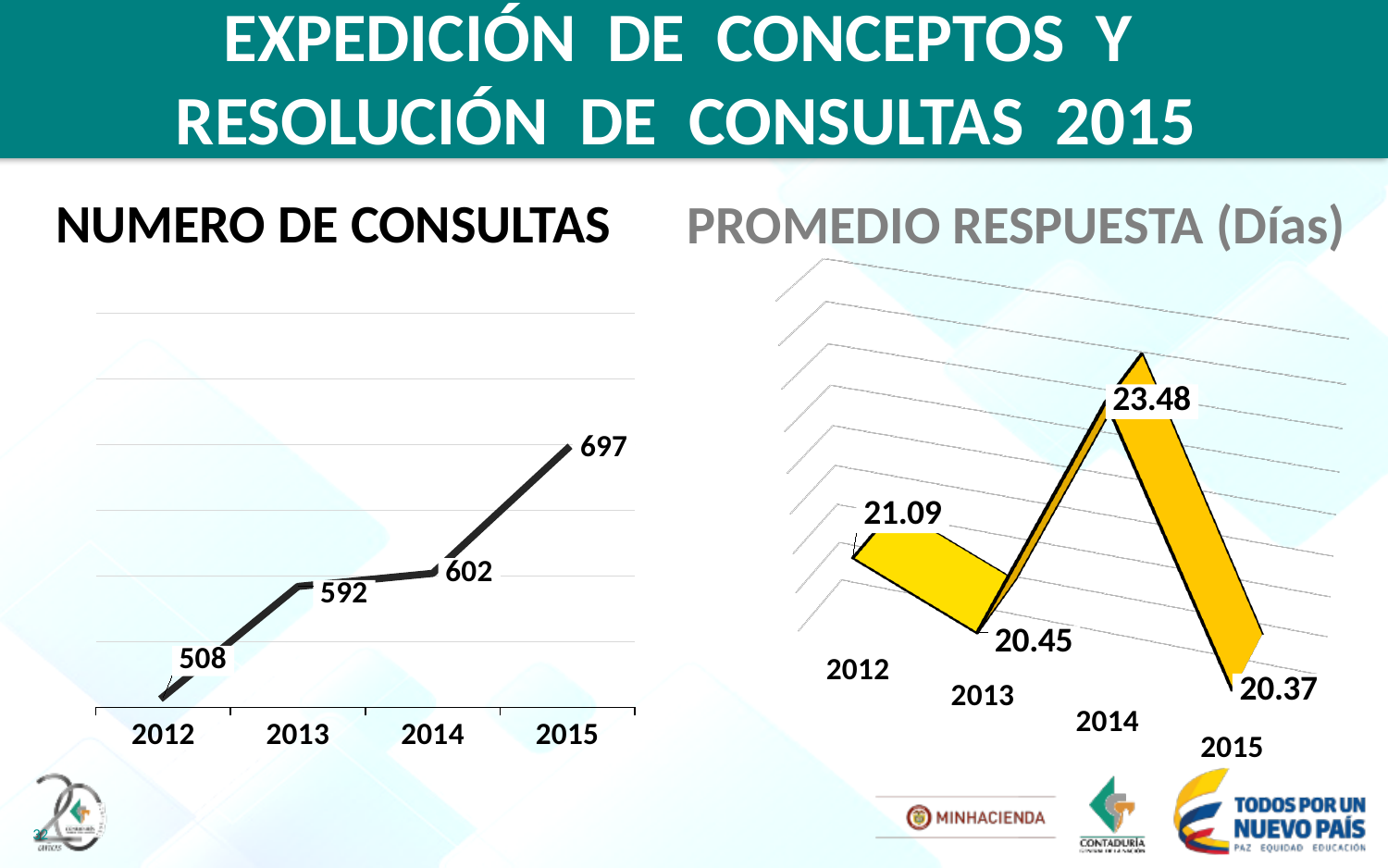
In the NUMERO DE CONSULTAS chart, how many years are plotted? 4 In the NUMERO DE CONSULTAS chart, what is the value for 2012? 508 In the PROMEDIO RESPUESTA (Días) chart, what is the value for 2013? 20.45 In the NUMERO DE CONSULTAS chart, what is the value for 2015? 697 In the NUMERO DE CONSULTAS chart, which year has the lowest value? 2012 In the PROMEDIO RESPUESTA (Días) chart, which year has the highest value? 2014 In the PROMEDIO RESPUESTA (Días) chart, which is larger, the value for 2012 or the value for 2015? 2012 In the PROMEDIO RESPUESTA (Días) chart, which year has the lowest value? 2015 What kind of chart is the NUMERO DE CONSULTAS chart? line chart In the NUMERO DE CONSULTAS chart, do the values rise or fall from 2012 to 2015? rise In the NUMERO DE CONSULTAS chart, what is the difference between the 2015 and 2014 values? 95 In the PROMEDIO RESPUESTA (Días) chart, what is the value for 2014? 23.48